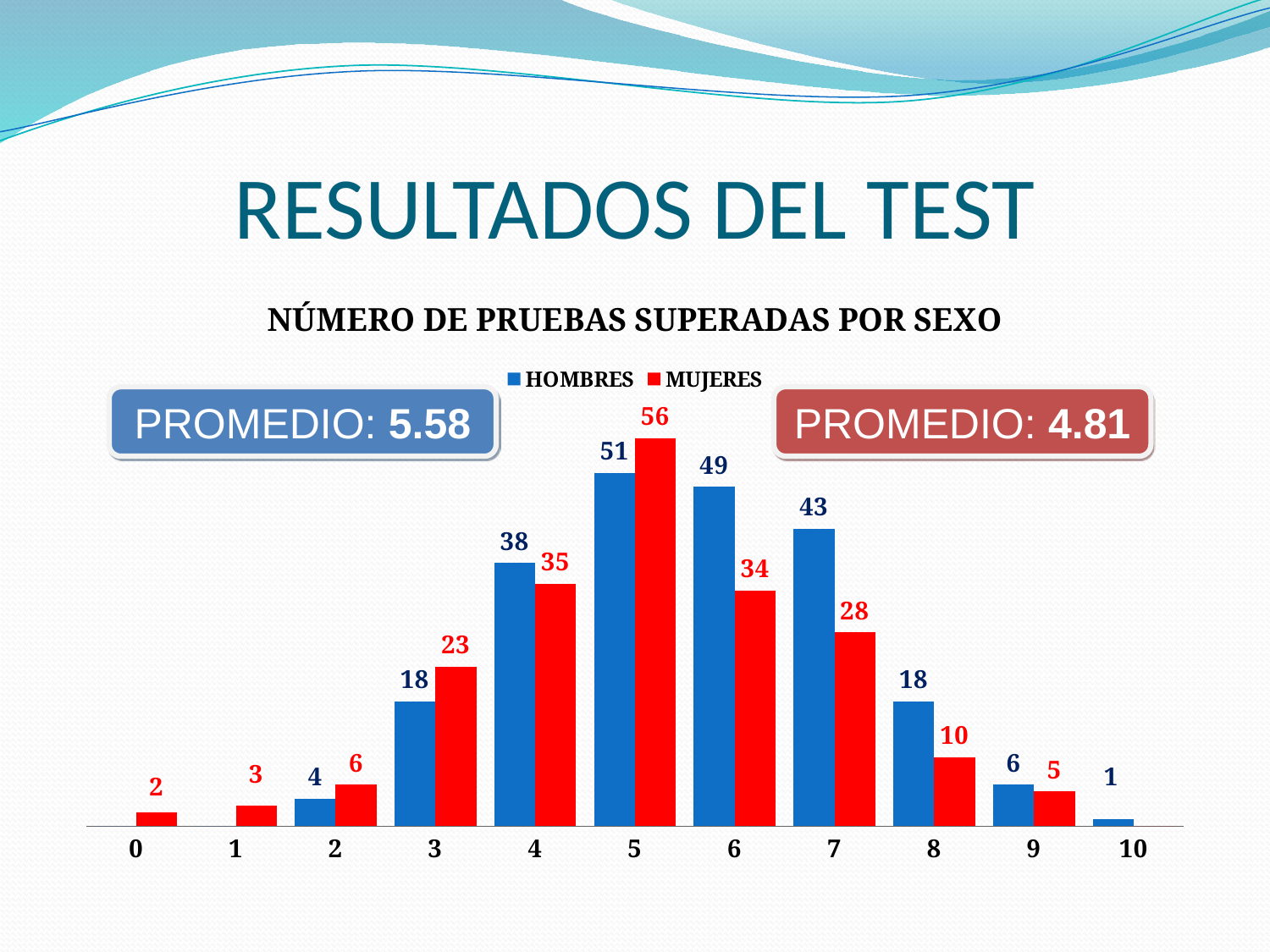
How many series does the legend list? 2 How many categories are shown on the x axis? 11 What kind of chart is shown on the slide? bar chart What is the value for HOMBRES at category 5? 51 What is the value for HOMBRES at category 7? 43 What is the difference between HOMBRES and MUJERES at category 6? 15 What is the value for MUJERES at category 8? 10 At which category is the HOMBRES series lowest among the categories where it has a bar? 10 What is the value for MUJERES at category 3? 23 Which is larger at category 4, HOMBRES or MUJERES? HOMBRES What is the title of the chart? NÚMERO DE PRUEBAS SUPERADAS POR SEXO At which category is the MUJERES series highest? 5